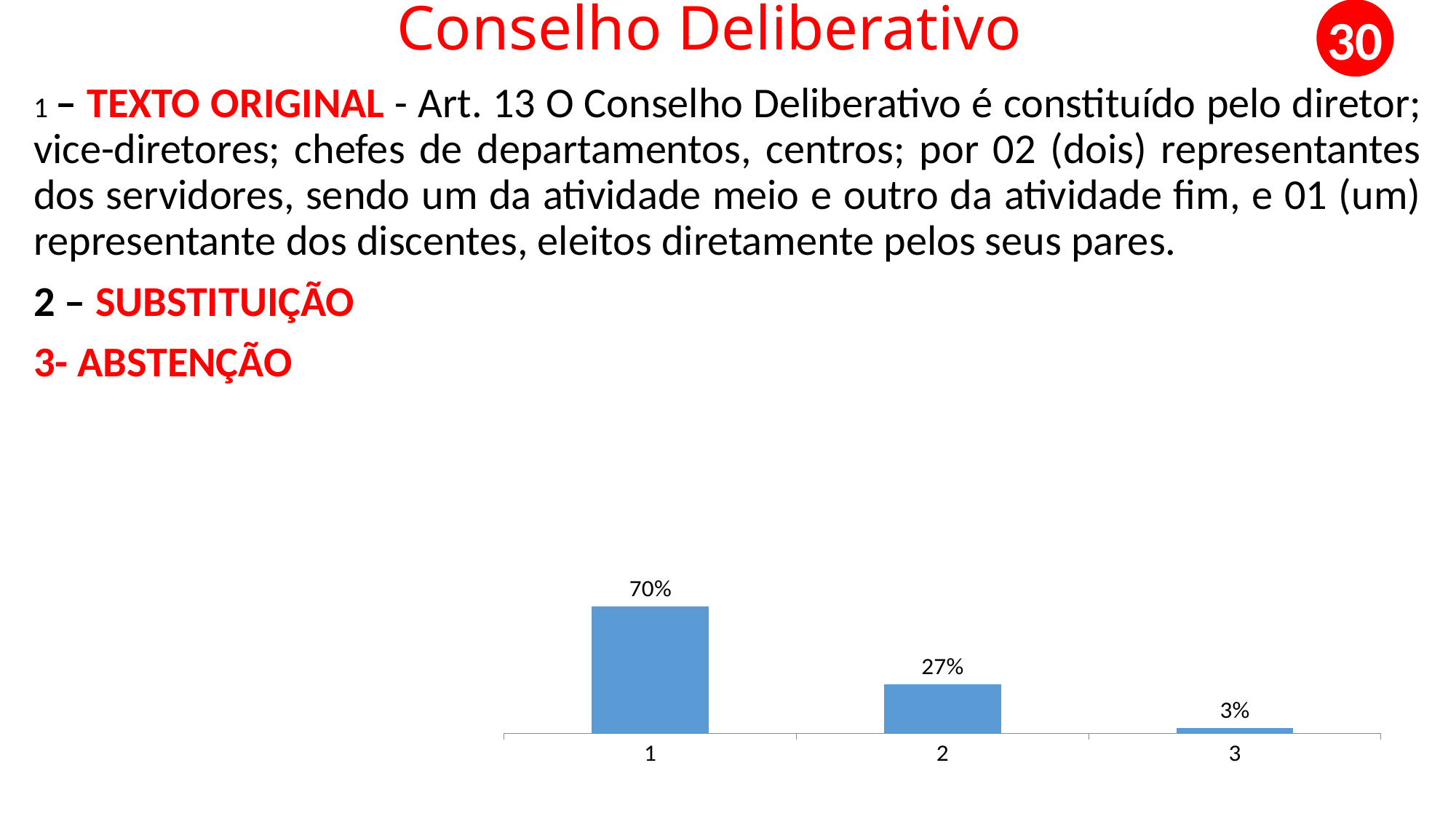
Which category has the highest value? 1 What is the value for category 3? 3% What is the difference between the values for category 2 and category 3? 24% Which category has the lowest value? 3 What is the difference between the values for category 1 and category 2? 43% What is the value for category 1? 70% Do the values rise or fall from category 1 to category 3? fall How many categories are shown on the x axis? 3 What colour are the bars in the chart? blue What kind of chart is shown on the slide? bar chart What is the value for category 2? 27% Which is larger, the value for category 2 or category 3? 2